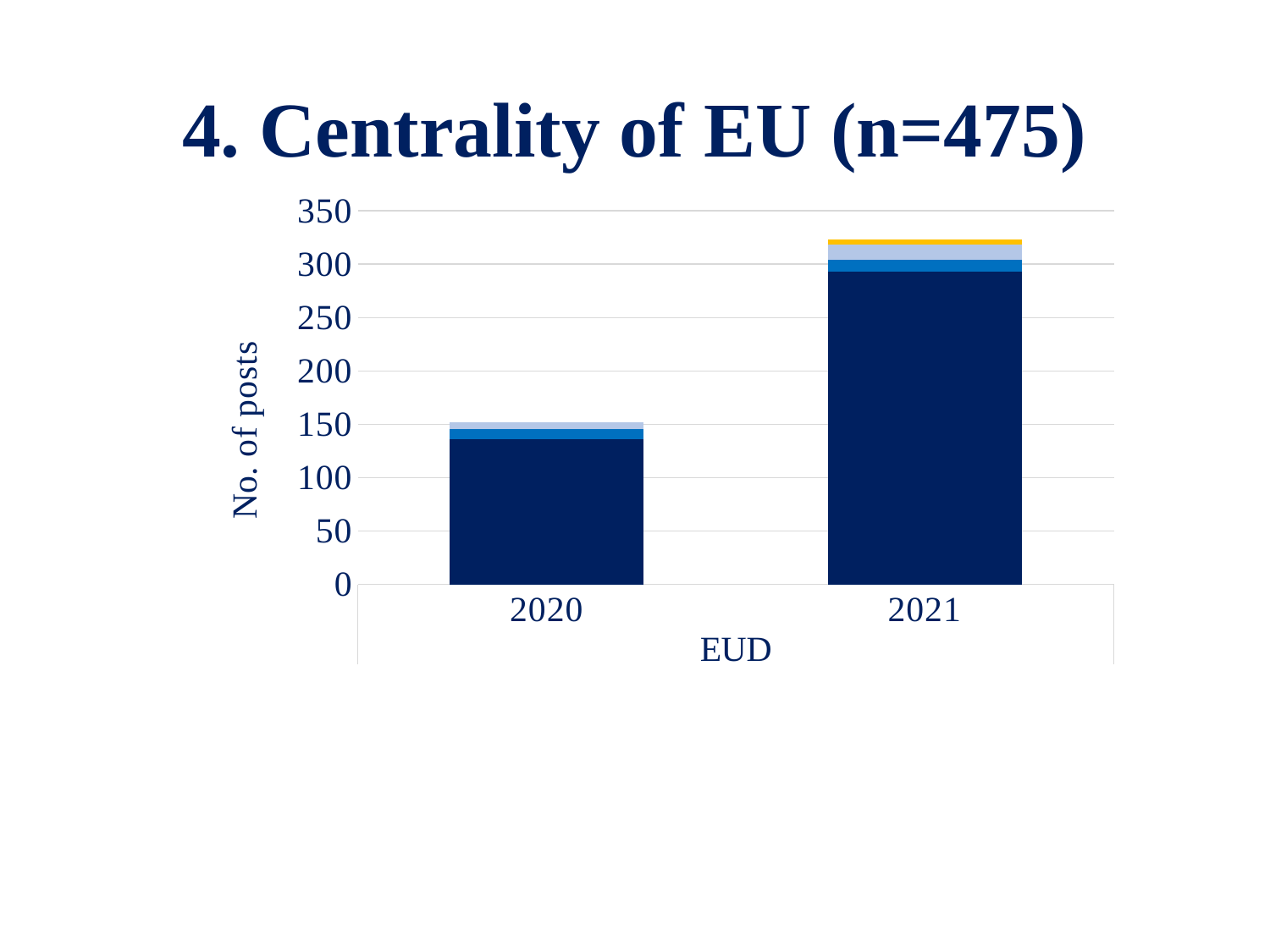
What is the title of the slide? 4. Centrality of EU (n=475) Is the total bar for 2021 larger or smaller than the total bar for 2020? larger How many categories are shown on the x axis of the chart? 2 Is the total value for 2020 greater or less than 100? greater Is the total value for 2021 greater or less than 350? less Which year has the shorter bar in the chart? 2020 Is the total value for 2020 greater or less than 200? less Which year has the taller bar in the chart? 2021 What is the label on the y axis of the chart? No. of posts Do the bar totals rise or fall from 2020 to 2021? rise What kind of chart is shown on the slide? stacked bar chart